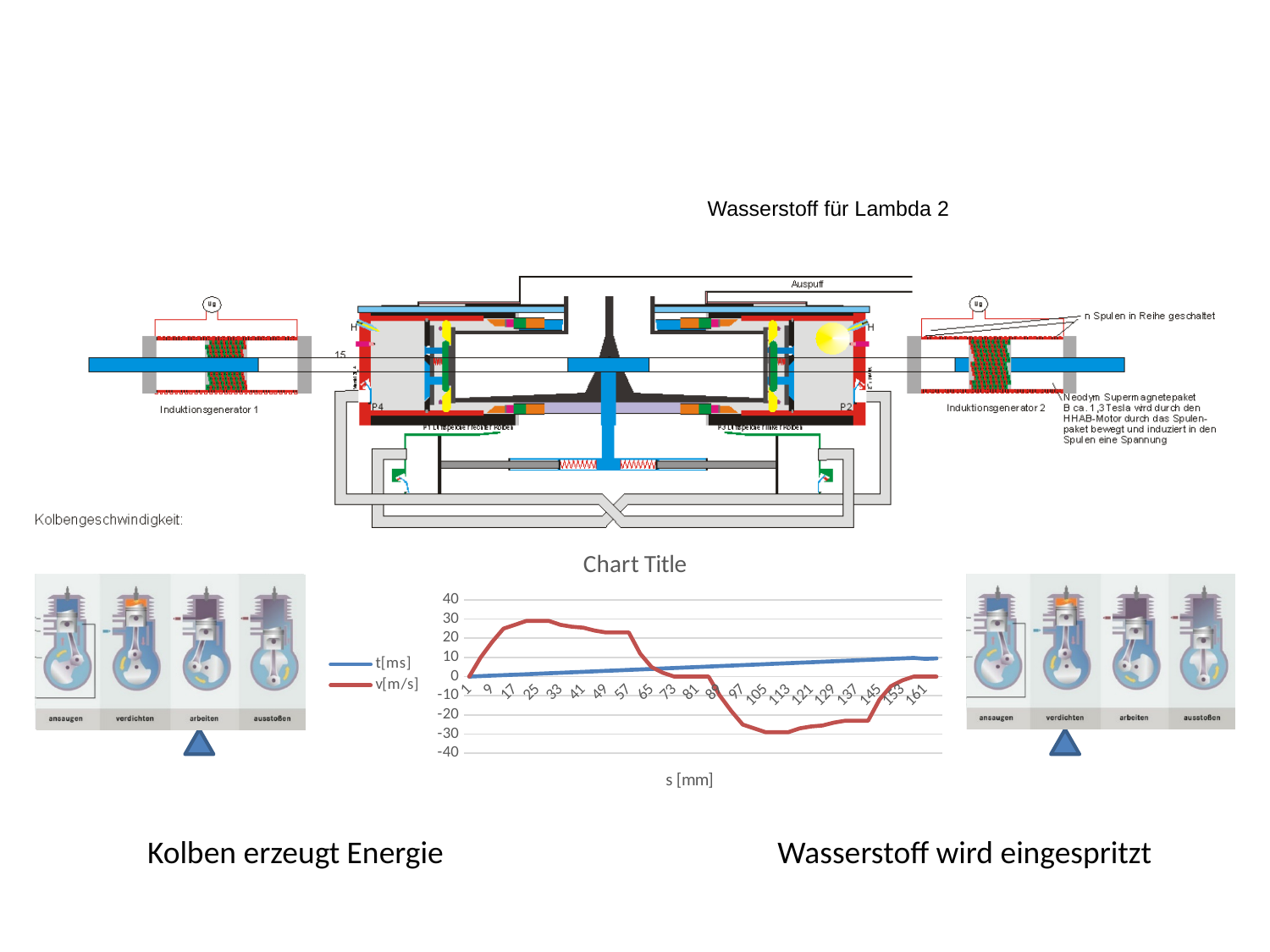
Which series is higher at s = 25, t[ms] or v[m/s]? v[m/s] Is the value of v[m/s] at s = 25 greater or less than 20? greater What is the label of the chart's x axis? s [mm] How many series does the chart legend list? 2 What is the highest value shown on the chart's y axis? 40 Is the value of t[ms] at s = 81 greater or less than 10? less What are the two series named in the chart legend? t[ms] and v[m/s] What kind of chart is shown on the slide? line chart Is the value of v[m/s] at s = 57 greater or less than 10? greater Does the t[ms] series rise or fall as s increases along the x axis? rise Which series is higher at s = 113, t[ms] or v[m/s]? t[ms]